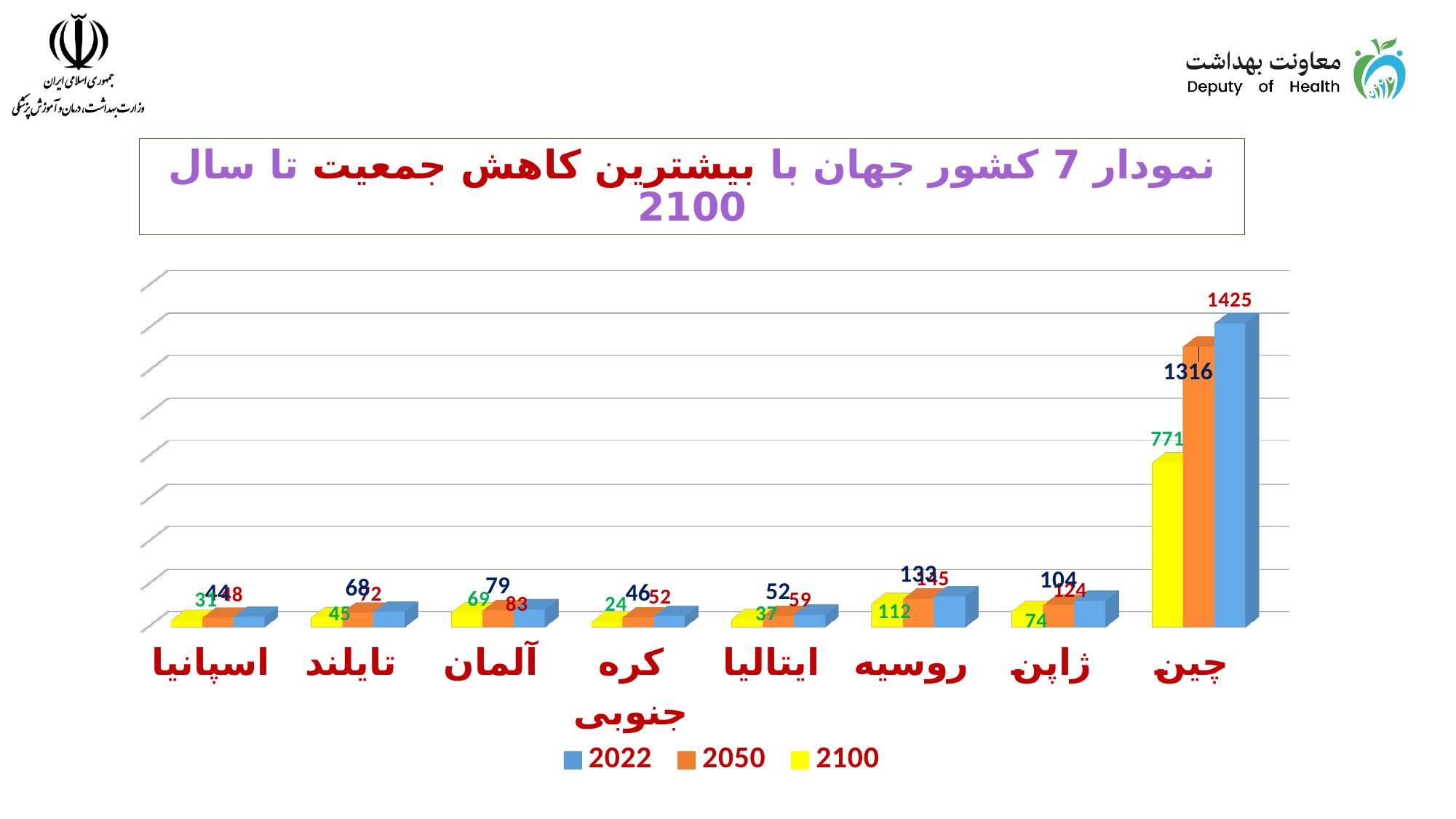
What is the 2100 value for کره جنوبی? 24 How many series does the legend list? 3 What is the 2050 value for ژاپن? 104 Which is larger, the 2022 value for ژاپن or the 2022 value for ایتالیا? ژاپن What is the 2022 value for آلمان? 83 What kind of chart is shown on the slide? bar chart Which category has the lowest 2100 value? کره جنوبی Which category has the highest 2022 value? چین What is the 2100 value for چین? 771 What is the 2022 value for چین? 1425 What is the difference between the 2022 and 2100 values for چین? 654 How many categories are shown on the x axis? 8